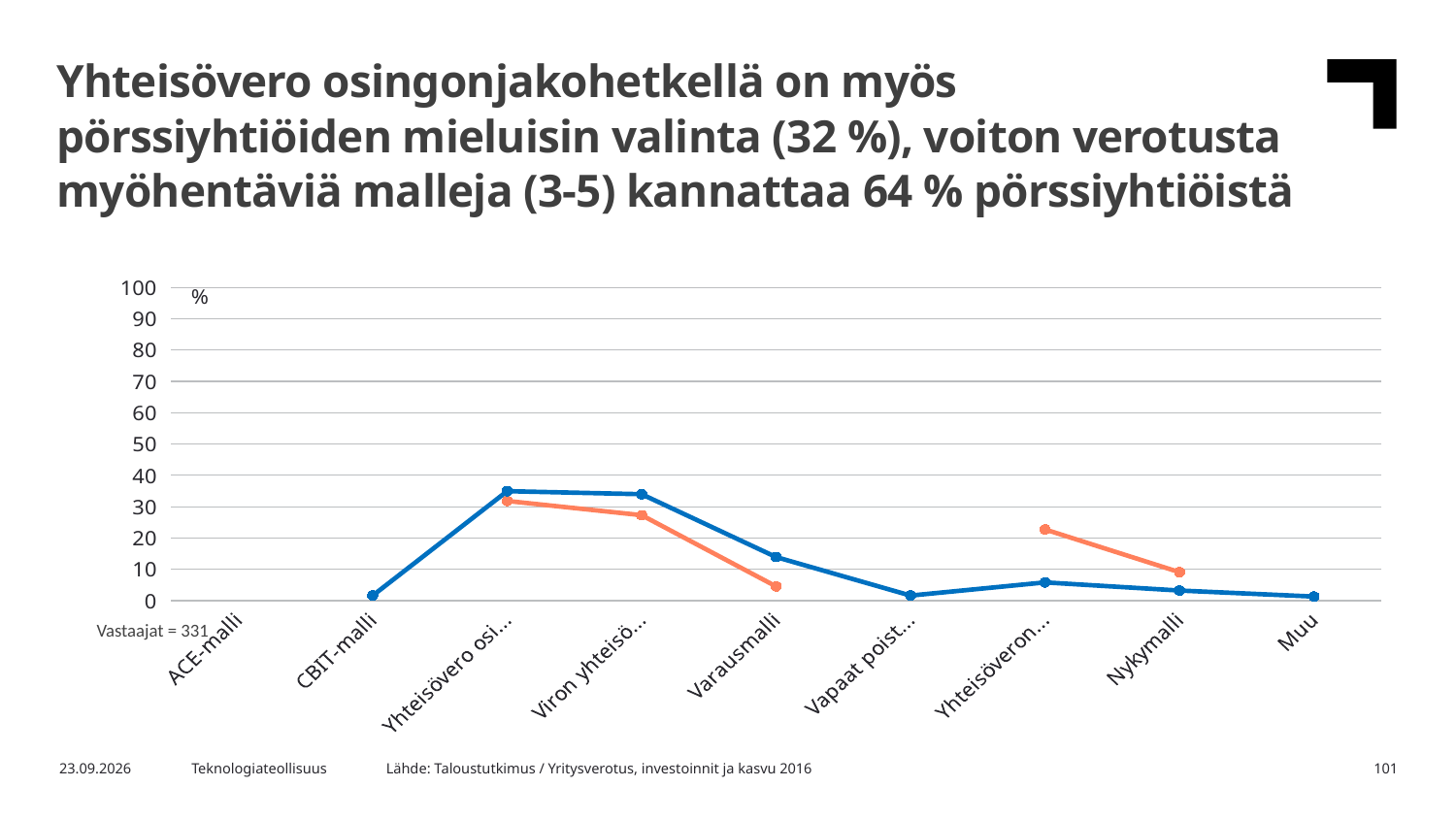
At 'Varausmalli', which line has the larger value, the blue or the orange? blue Is the value of the orange line for 'Yhteisöveron...' greater or less than 10? greater How many categories are shown on the x axis of the chart? 9 What kind of chart is shown on the slide? line chart What unit label is shown at the top of the y axis? % Is the value of the blue line for 'Viron yhteisö...' greater or less than 30? greater Is the value of the blue line for 'Yhteisövero osi...' greater or less than 20? greater How many lines (series) are plotted on the chart? 2 At 'Yhteisöveron...', which line has the larger value, the blue or the orange? orange For which category does the orange line reach its highest value? Yhteisövero osi...